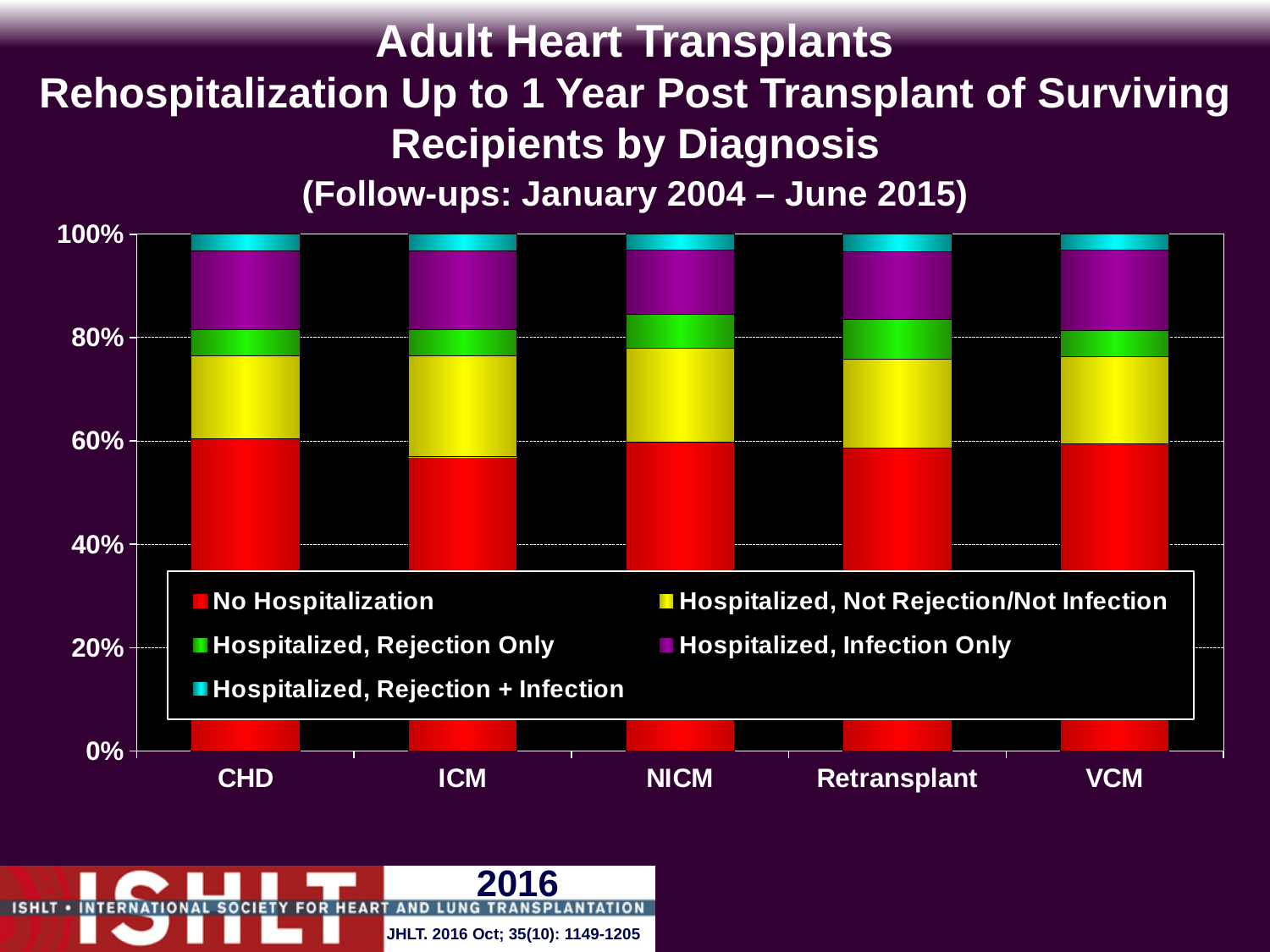
Is the No Hospitalization share for CHD greater or less than 40%? greater What is the highest value shown on the y axis? 100% How many series does the legend list? 5 How many diagnosis categories are shown on the x axis? 5 Which has the larger Hospitalized, Rejection Only segment, NICM or ICM? NICM What kind of chart is shown on the slide? Stacked bar chart Is the No Hospitalization share for Retransplant greater or less than 60%? less Is the top of the Hospitalized, Rejection Only segment for NICM above or below the 80% line? above Which colour represents No Hospitalization in the legend? Red What follow-up period is stated in the chart title? January 2004 – June 2015 Which diagnosis has the largest Hospitalized, Rejection Only segment? Retransplant